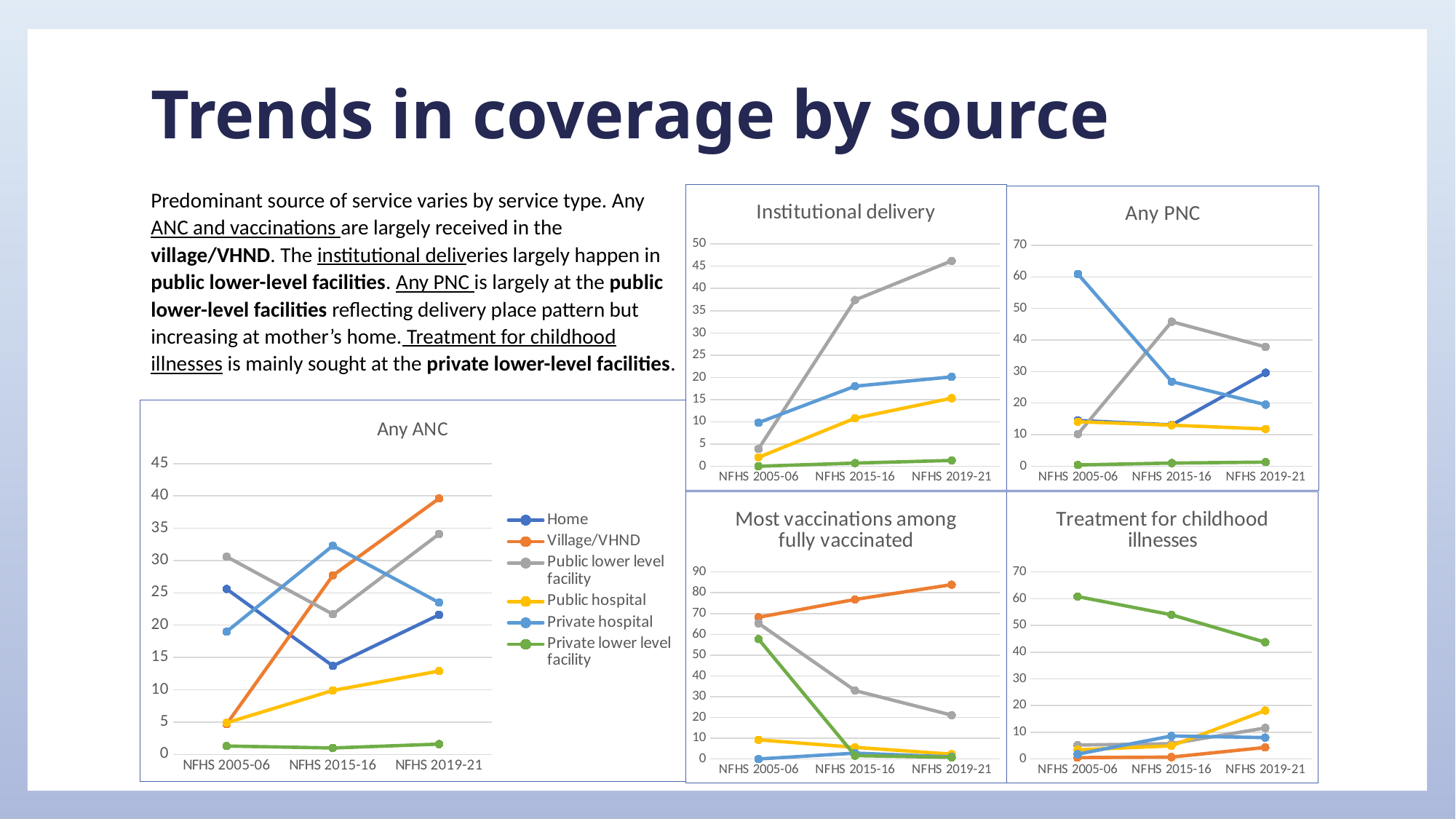
In the "Any ANC" chart, does the Village/VHND series rise or fall from NFHS 2005-06 to NFHS 2019-21? rise How many series does the legend of the "Any ANC" chart list? 6 What kind of chart is the "Any ANC" chart? line chart In the "Any ANC" chart, which is larger at NFHS 2019-21: Village/VHND or Public lower level facility? Village/VHND In the "Institutional delivery" chart, which series has the highest value at NFHS 2019-21? Public lower level facility In the "Any PNC" chart, is the value for Private hospital at NFHS 2005-06 greater or less than 50? greater How many charts are shown on the slide? 5 In the "Institutional delivery" chart, is the value for Public lower level facility at NFHS 2019-21 greater or less than 40? greater How many survey rounds are shown on the x axis of the "Any ANC" chart? 3 In the "Most vaccinations among fully vaccinated" chart, is the value for Village/VHND at NFHS 2019-21 greater or less than 80? greater In the "Any PNC" chart, does the Private hospital series rise or fall from NFHS 2005-06 to NFHS 2019-21? fall In the "Treatment for childhood illnesses" chart, which series has the highest value at NFHS 2005-06? Private lower level facility